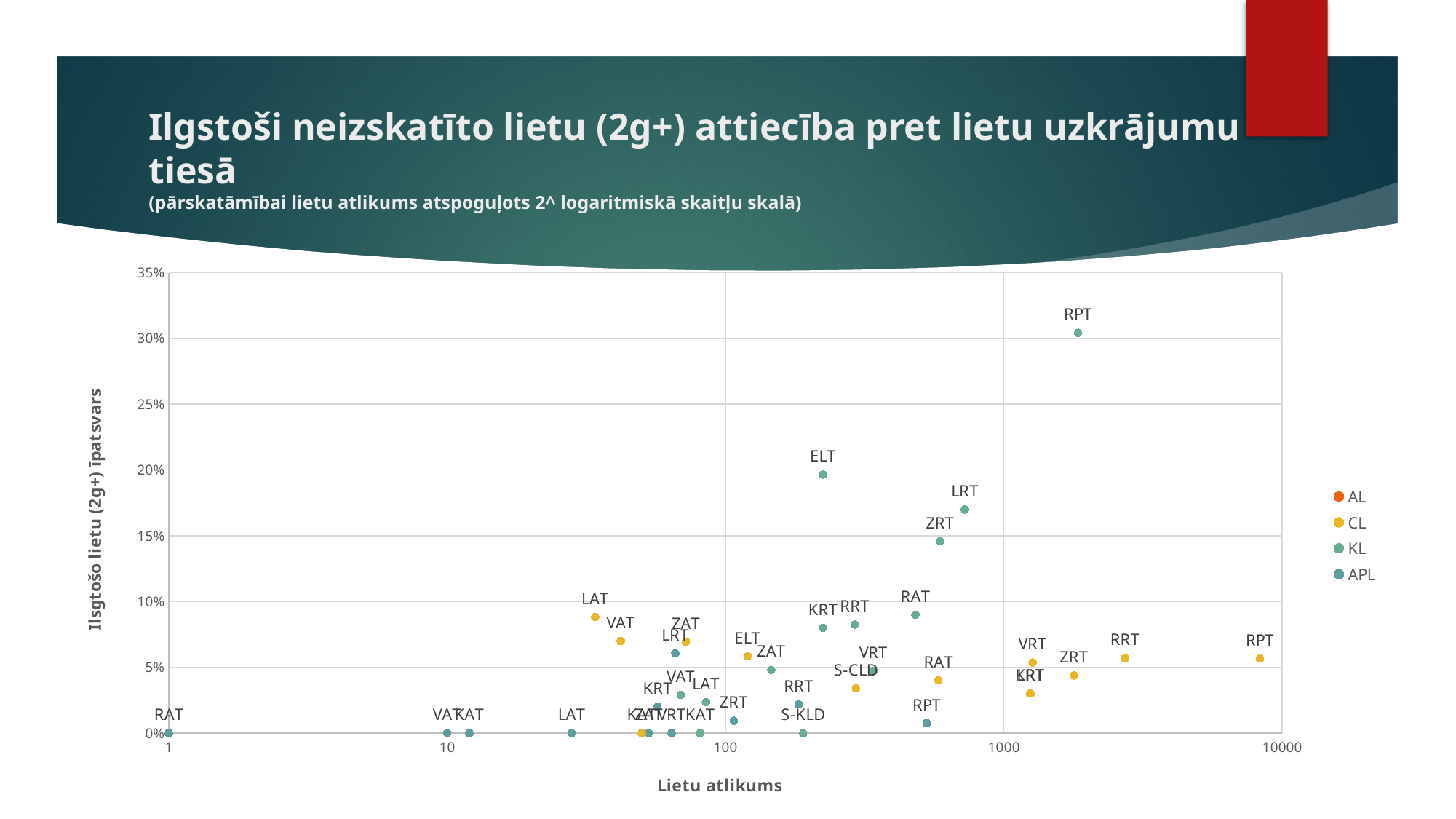
Is the value for the ELT point near the 200 mark on the x axis greater or less than 15%? greater Is the value for the LRT point near the 700 mark on the x axis greater or less than 15%? greater Which series are listed in the legend? AL, CL, KL, APL What kind of chart is shown on the slide? Scatter chart How many series does the legend list? 4 Is the value for the highest RPT point greater or less than 25%? greater Which has a higher vertical-axis value, the ELT point near 200 on the x axis or the LRT point near 700 on the x axis? ELT What is the highest value shown on the vertical axis? 35% Which labeled point has the highest value on the vertical axis? RPT Which has a higher vertical-axis value, the highest RPT point or the ELT point near 200 on the x axis? RPT What is the title of the horizontal axis? Lietu atlikums